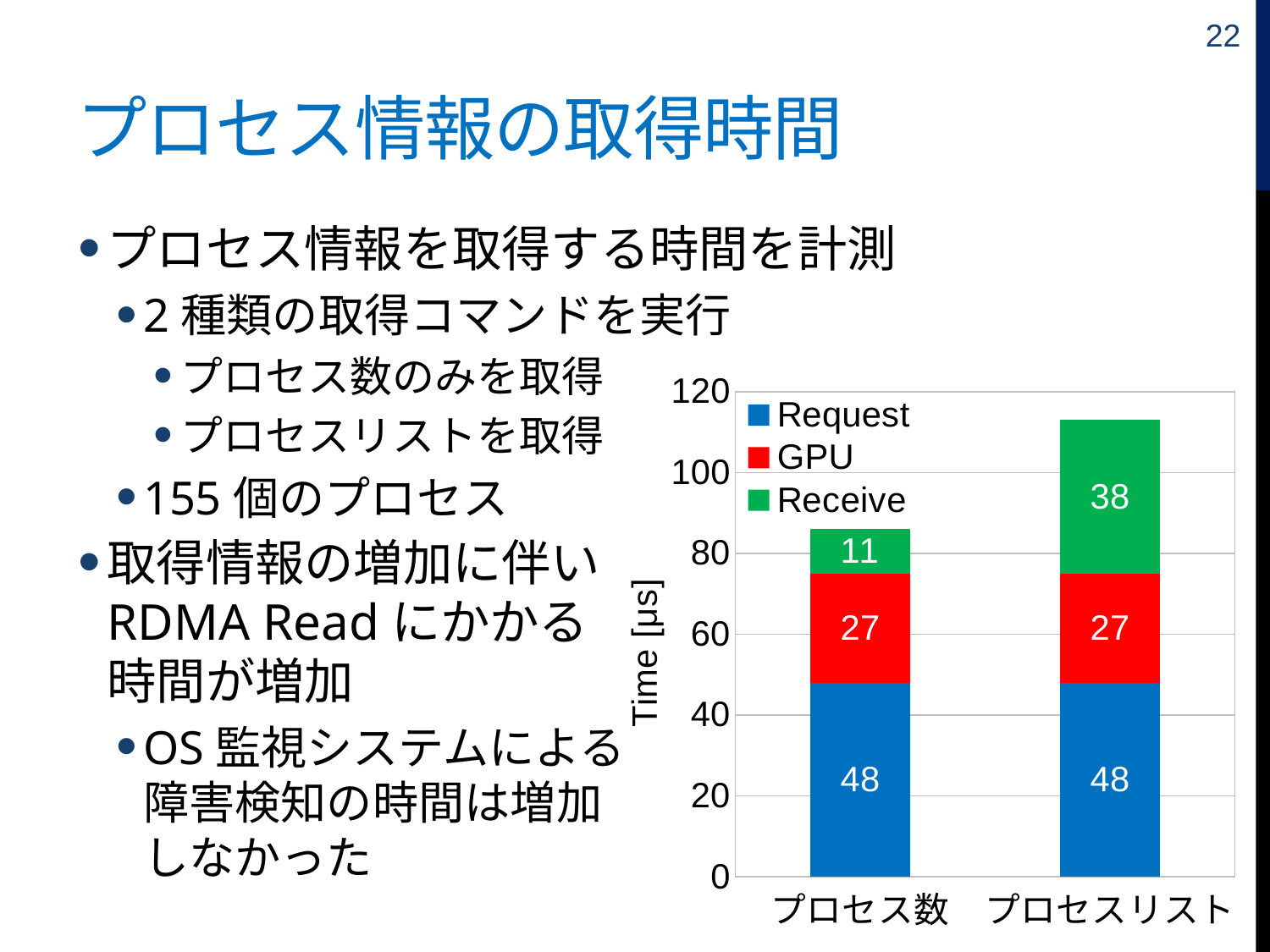
What is the GPU value for プロセスリスト? 27 What kind of chart is shown? Stacked bar chart What is the Receive value for プロセスリスト? 38 How many series does the legend list? 3 What is the difference between the Receive values for プロセスリスト and プロセス数? 27 What is the label of the y axis? Time [μs] What is the total of the stacked bar for プロセスリスト? 113 What is the Request value for プロセス数? 48 Which category has the highest total time? プロセスリスト Which category has the higher Receive value, プロセス数 or プロセスリスト? プロセスリスト What is the total of the stacked bar for プロセス数? 86 What is the Receive value for プロセス数? 11